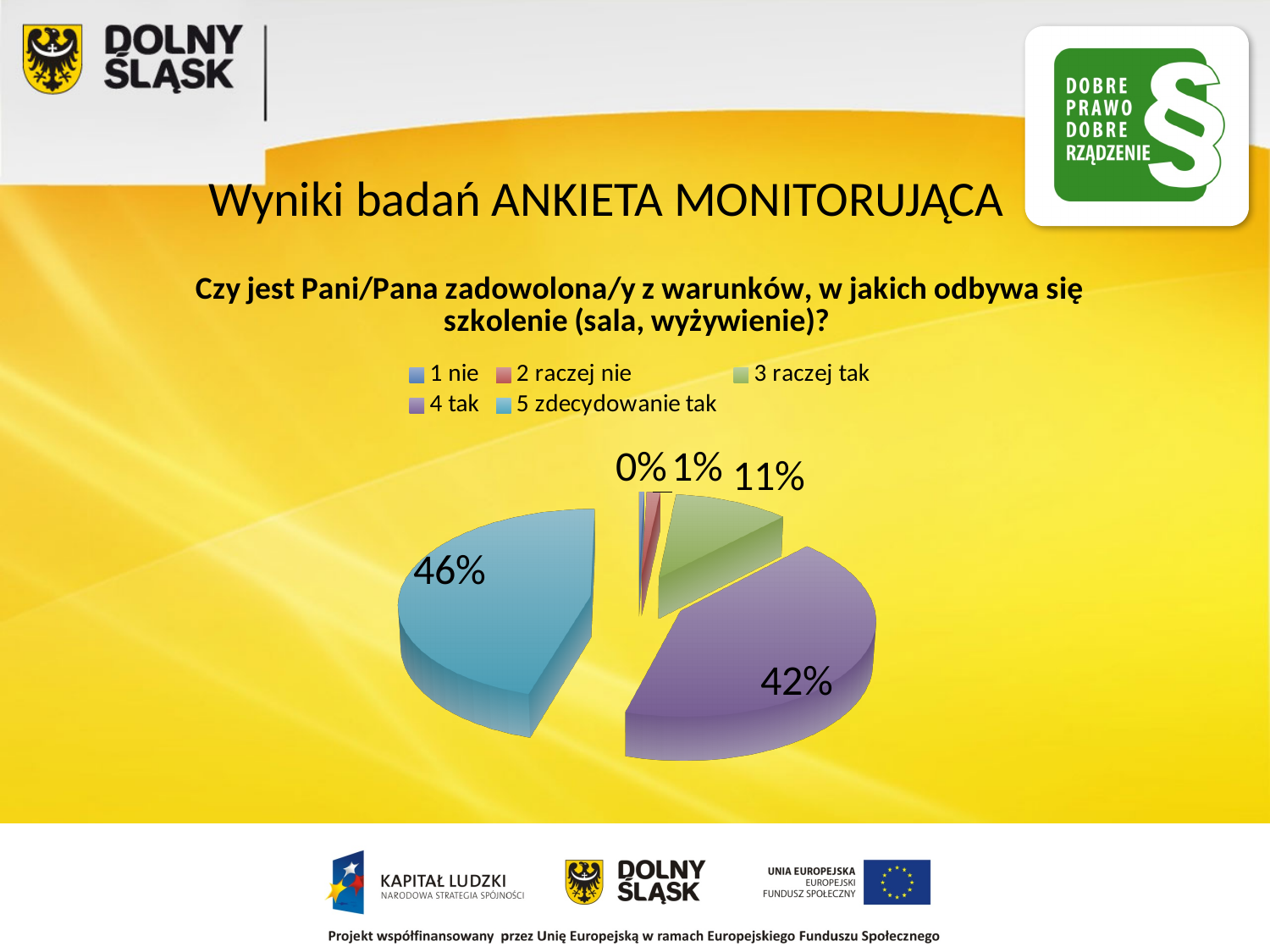
Which is larger, the slice for "3 raczej tak" or the slice for "2 raczej nie"? 3 raczej tak What share of the pie does "5 zdecydowanie tak" have? 46% What share of the pie does "3 raczej tak" have? 11% Which category has the smallest slice of the pie? 1 nie What share of the pie does "1 nie" have? 0% What is the difference in percentage points between "5 zdecydowanie tak" and "4 tak"? 4 What share of the pie does "4 tak" have? 42% What share of the pie does "2 raczej nie" have? 1% What is the title of the chart? Czy jest Pani/Pana zadowolona/y z warunków, w jakich odbywa się szkolenie (sala, wyżywienie)? What kind of chart is shown on the slide? pie chart Which category has the largest slice of the pie? 5 zdecydowanie tak How many categories does the legend list? 5